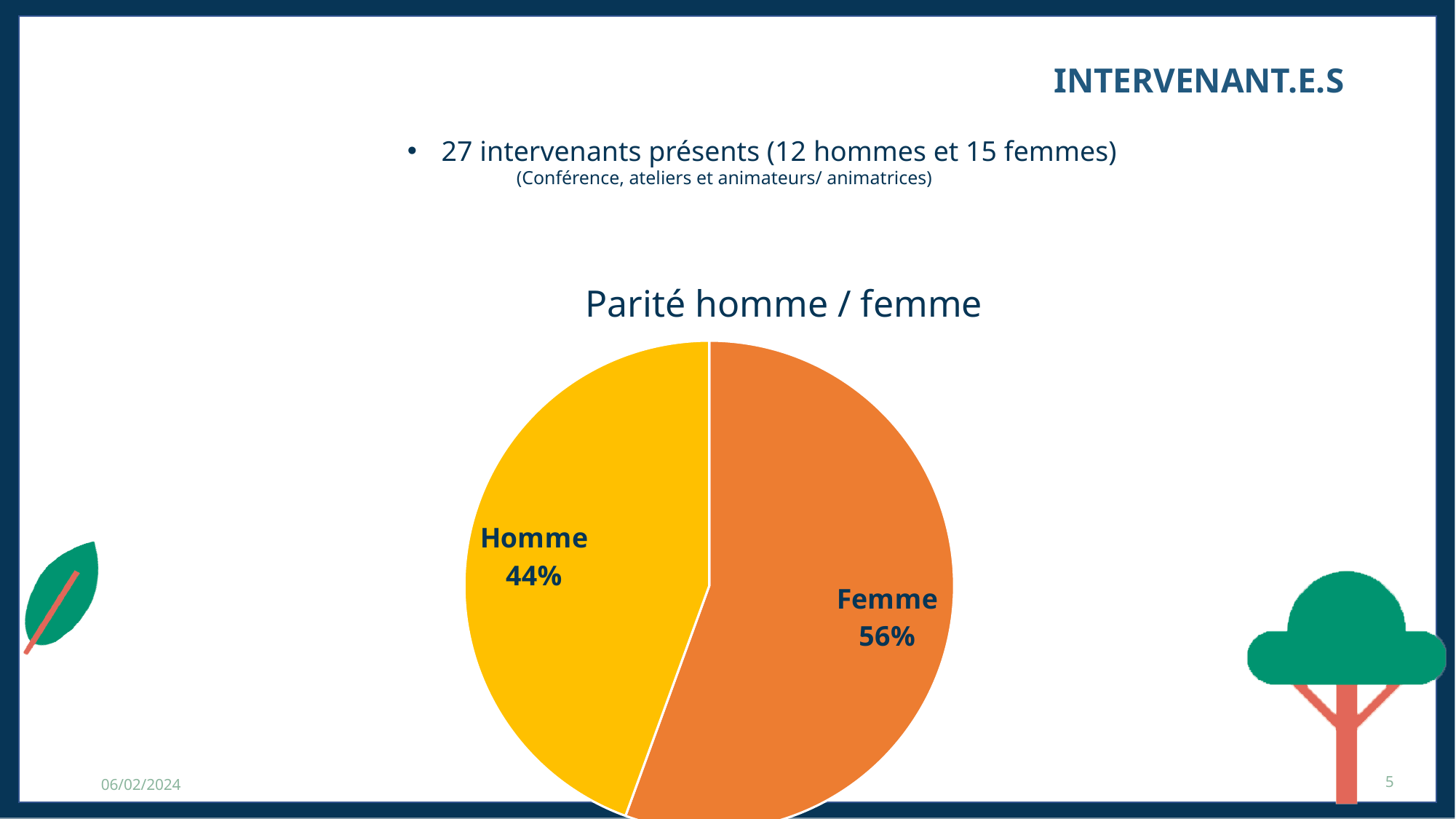
What share of the pie does the Femme slice represent? 56% Which slice of the pie is the largest? Femme What is the title of the chart? Parité homme / femme What colour is the Homme slice? yellow What percentage of the pie is labelled Homme? 44% What is the difference in percentage points between the Femme and Homme slices? 12 How many slices does the pie chart have? 2 Which slice is larger, Homme or Femme? Femme What percentage of the pie is labelled Femme? 56% What type of chart is shown on the slide? pie chart Which slice of the pie is the smallest? Homme